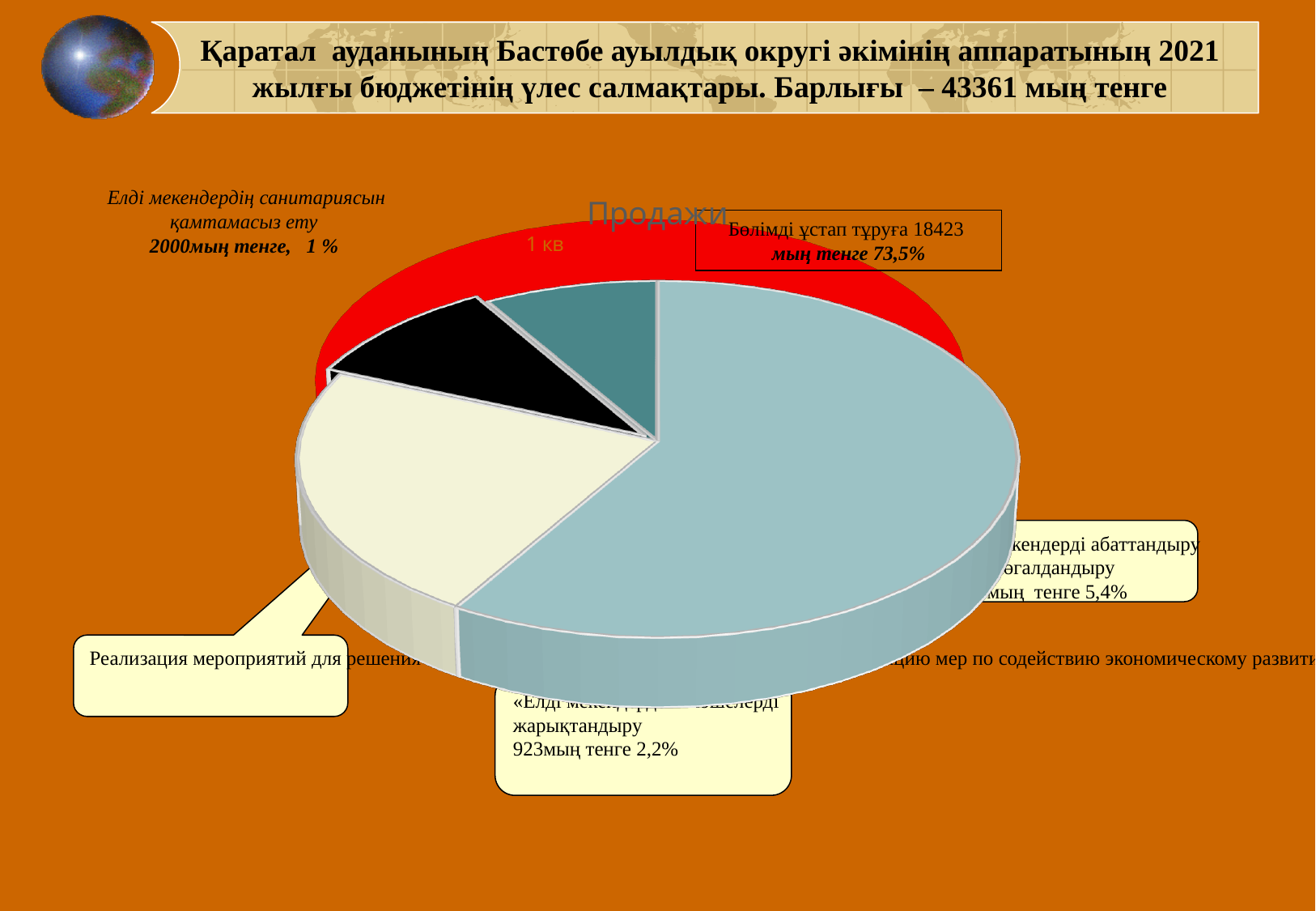
What is the total budget stated in the slide title? 43361 мың тенге What percentage share is given for "Елді мекендердің санитариясын қамтамасыз ету"? 1 % What is the title printed on the chart? Продажи How many slices does the pie chart have? 4 What amount is given for street lighting ("жарықтандыру")? 923 мың тенге What amount is given for "Бөлімді ұстап тұруға"? 18423 мың тенге Which is larger, the amount for "Бөлімді ұстап тұруға" or the amount for street lighting ("жарықтандыру")? Бөлімді ұстап тұруға What kind of chart is shown on the slide? pie chart What is the difference between the amount for "Бөлімді ұстап тұруға" (18423) and the amount for street lighting (923)? 17500 мың тенге What percentage share is given for street lighting ("жарықтандыру")? 2,2% What amount is given for "Елді мекендердің санитариясын қамтамасыз ету"? 2000 мың тенге What percentage share is given for "Бөлімді ұстап тұруға"? 73,5%